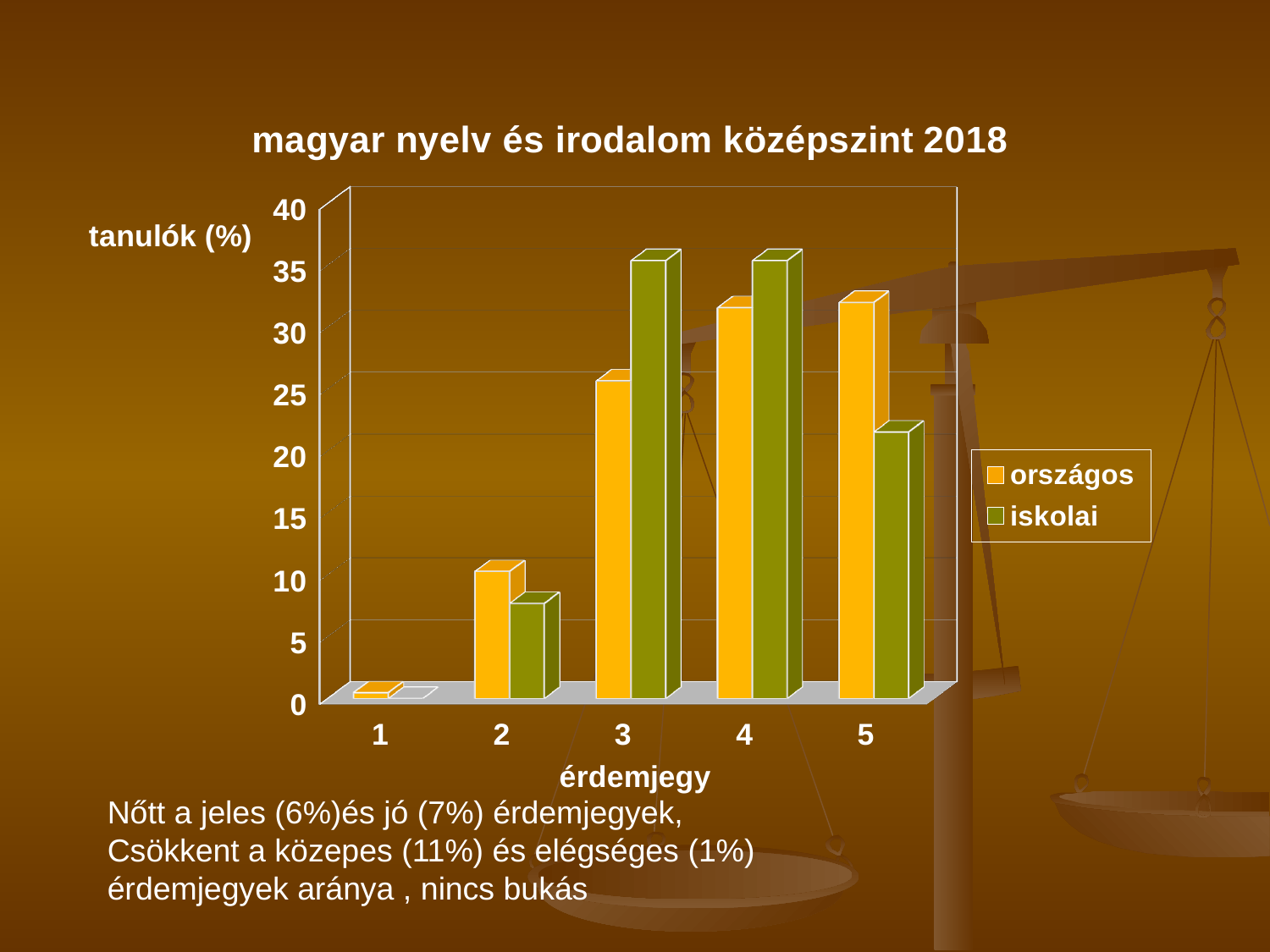
For grade 2, which series has the larger value, országos or iskolai? országos For grade 3, which series has the larger value, országos or iskolai? iskolai What is the label of the vertical axis? tanulók (%) What kind of chart is shown on the slide? bar chart What is the title of the chart? magyar nyelv és irodalom középszint 2018 Is the országos value for grade 3 greater or less than 30? less How many grade categories (érdemjegy) are shown on the x axis? 5 Is the iskolai value for grade 5 greater or less than 25? less Which grade has the lowest value for the országos series? 1 Is the iskolai value for grade 3 greater or less than 30? greater How many series does the legend list? 2 For grade 5, which series has the larger value, országos or iskolai? országos